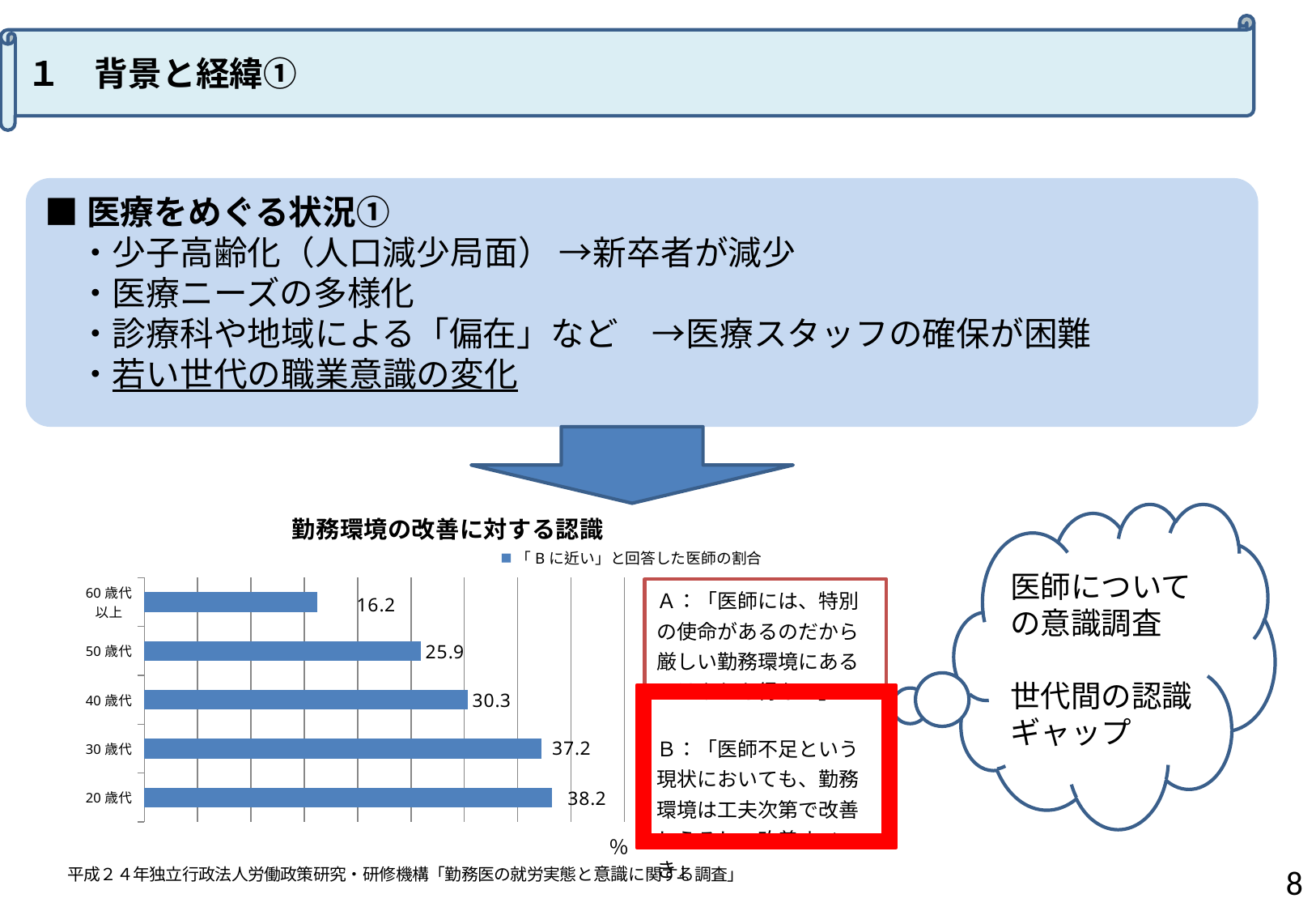
What is the value for 40歳代 in the chart 勤務環境の改善に対する認識? 30.3 In the chart 勤務環境の改善に対する認識, which is larger, the value for 40歳代 or the value for 50歳代? 40歳代 How many age groups are shown in the chart 勤務環境の改善に対する認識? 5 What is the legend entry of the chart 勤務環境の改善に対する認識? 「Bに近い」と回答した医師の割合 What kind of chart is 勤務環境の改善に対する認識? bar chart Which age group has the highest value in the chart 勤務環境の改善に対する認識? 20歳代 What is the value for 60歳代以上 in the chart 勤務環境の改善に対する認識? 16.2 What is the value for 50歳代 in the chart 勤務環境の改善に対する認識? 25.9 Which age group has the lowest value in the chart 勤務環境の改善に対する認識? 60歳代以上 What is the difference between the values for 20歳代 and 60歳代以上 in the chart 勤務環境の改善に対する認識? 22.0 What is the difference between the values for 30歳代 and 50歳代 in the chart 勤務環境の改善に対する認識? 11.3 What is the value for 20歳代 in the chart 勤務環境の改善に対する認識? 38.2